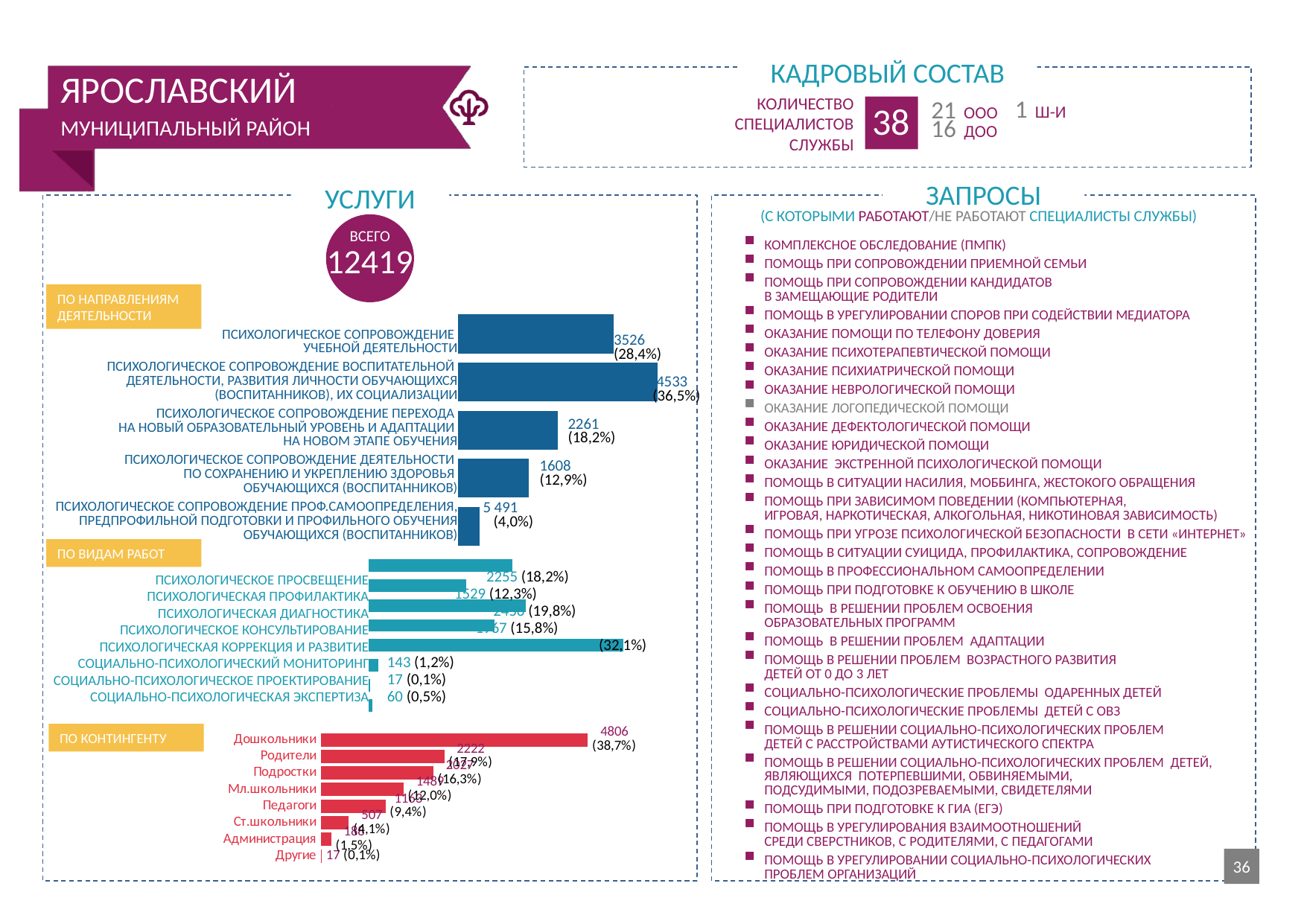
What type of chart is the "ПО КОНТИНГЕНТУ" chart? Bar chart In the "ПО ВИДАМ РАБОТ" chart, which type of work has the lowest value? Социально-психологическое проектирование How many categories are shown in the "ПО НАПРАВЛЕНИЯМ ДЕЯТЕЛЬНОСТИ" chart? 5 In the "ПО ВИДАМ РАБОТ" chart, which is larger: "Социально-психологический мониторинг" or "Социально-психологическая экспертиза"? Социально-психологический мониторинг In the "ПО ВИДАМ РАБОТ" chart, what percentage is shown for "Психологическая коррекция и развитие"? 32,1% In the "ПО НАПРАВЛЕНИЯМ ДЕЯТЕЛЬНОСТИ" chart, what is the difference between the values for "Психологическое сопровождение воспитательной деятельности" and "Психологическое сопровождение учебной деятельности"? 1007 In the "ПО ВИДАМ РАБОТ" chart, what is the value for "Психологическое просвещение"? 2255 In the "ПО КОНТИНГЕНТУ" chart, what is the value for "Дошкольники"? 4806 In the "ПО КОНТИНГЕНТУ" chart, which category has the lowest value? Другие In the "ПО НАПРАВЛЕНИЯМ ДЕЯТЕЛЬНОСТИ" chart, which direction has the highest value? Психологическое сопровождение воспитательной деятельности, развития личности обучающихся (воспитанников), их социализации In the "ПО НАПРАВЛЕНИЯМ ДЕЯТЕЛЬНОСТИ" chart, what percentage is shown for "Психологическое сопровождение перехода на новый образовательный уровень и адаптации на новом этапе обучения"? 18,2% In the "ПО НАПРАВЛЕНИЯМ ДЕЯТЕЛЬНОСТИ" chart, what is the value for "Психологическое сопровождение учебной деятельности"? 3526